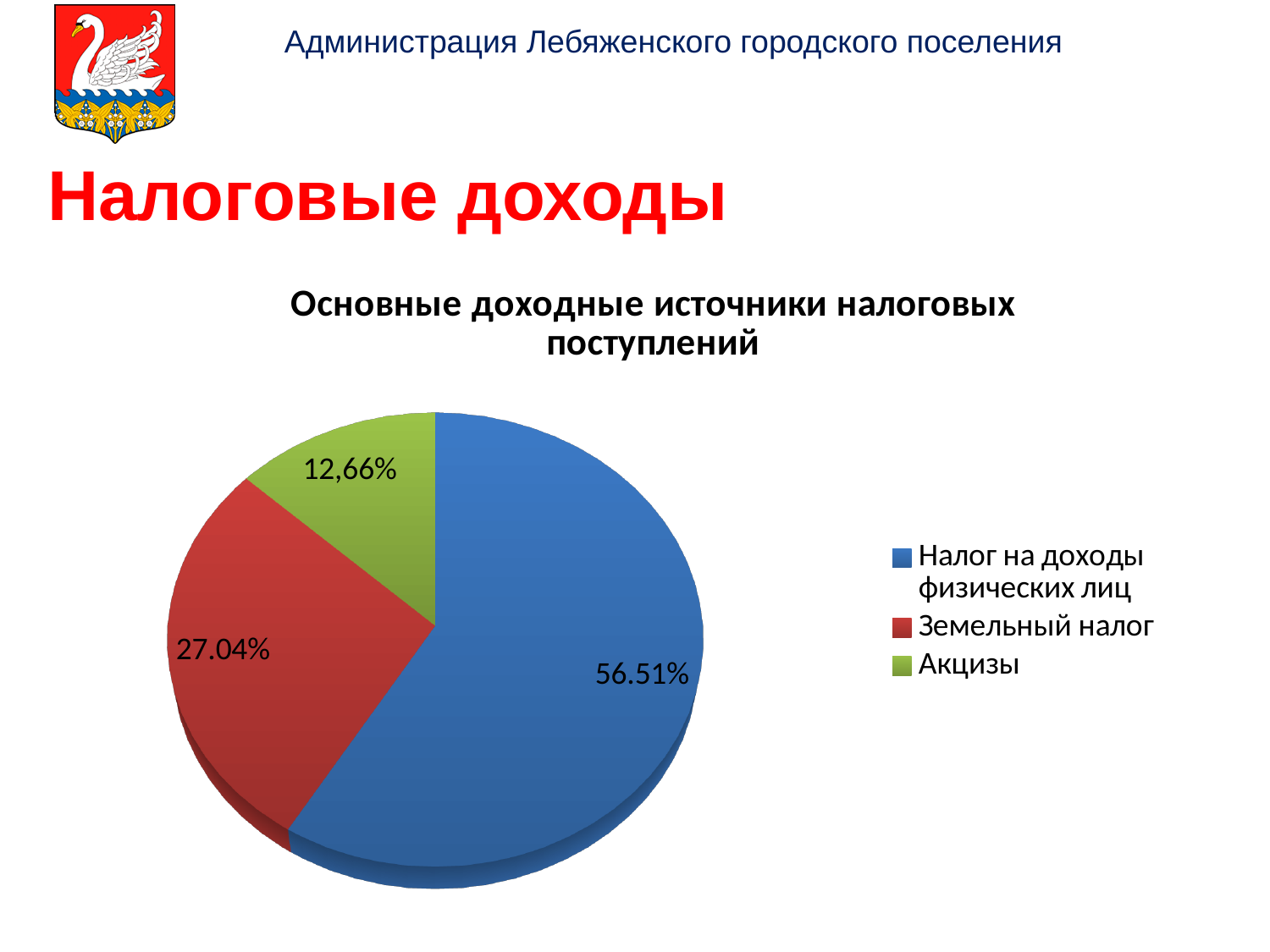
Which category has the largest slice of the pie? Налог на доходы физических лиц What share of the pie is labelled for Земельный налог? 27.04% What is the difference in percentage points between the Налог на доходы физических лиц slice and the Земельный налог slice? 29.47 What is the title of the chart? Основные доходные источники налоговых поступлений Which is larger: the slice for Земельный налог or the slice for Акцизы? Земельный налог Which category has the smallest slice of the pie? Акцизы What share of the pie is labelled for Акцизы? 12,66% How many entries does the legend list? 3 What type of chart is shown on the slide? Pie chart What share of the pie is labelled for Налог на доходы физических лиц? 56.51% What colour is the slice for Акцизы? Green How many slices does the pie chart have? 3